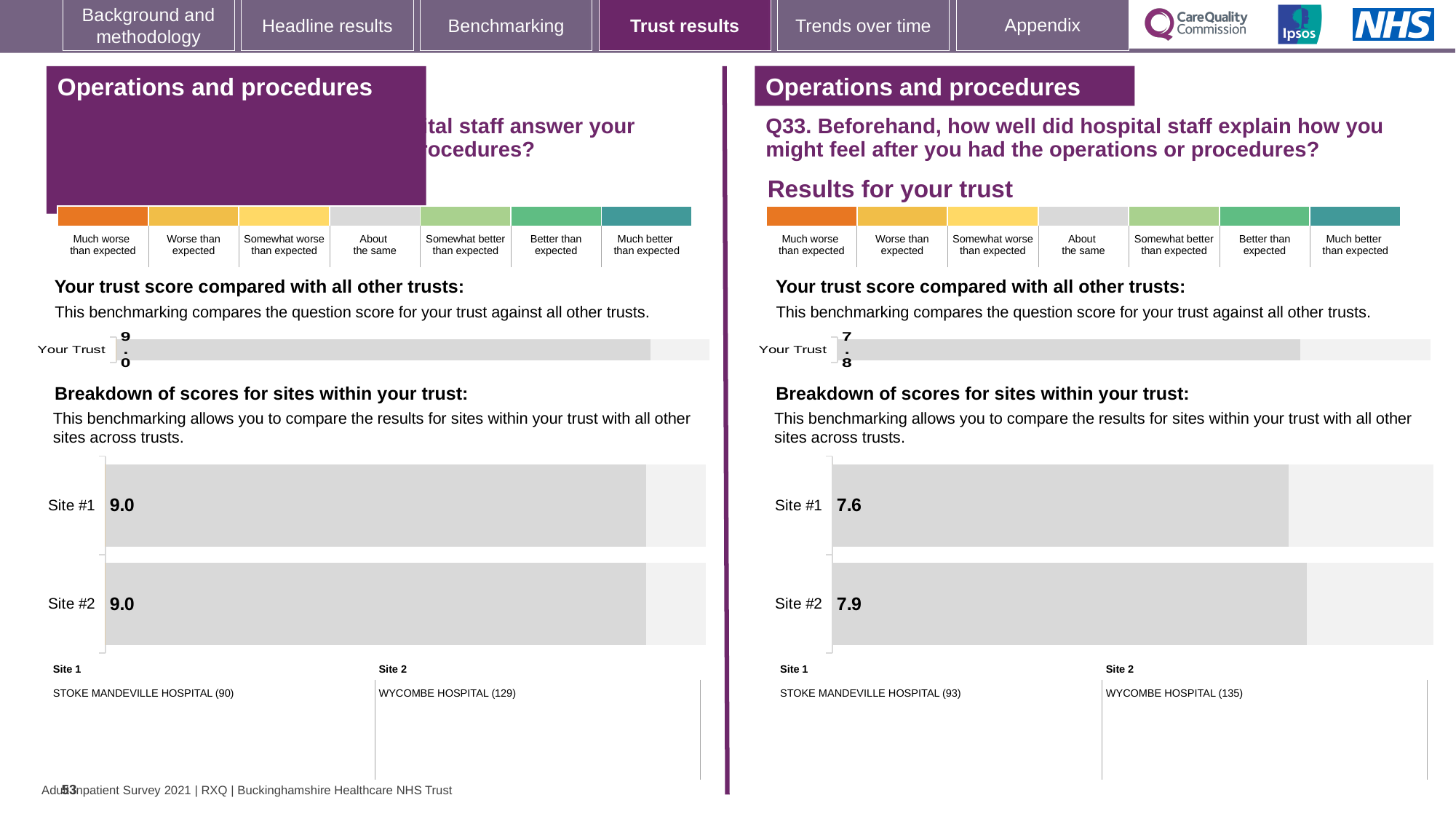
On the right-hand (Q33) 'Breakdown of scores for sites within your trust' chart, what is the score for Site #1? 7.6 On the right-hand (Q33) site breakdown chart, which site has the higher score? Site #2 On the left-hand 'Breakdown of scores for sites within your trust' chart, what is the score for Site #1? 9.0 On the left-hand 'Breakdown of scores for sites within your trust' chart, what is the score for Site #2? 9.0 On the right-hand (Q33) site breakdown chart, what is the difference between the Site #2 and Site #1 scores? 0.3 On the left-hand 'Your trust score compared with all other trusts' chart, what is the score shown for Your Trust? 9.0 On the right-hand (Q33) site breakdown chart, is the score for Site #1 larger or smaller than the score for Site #2? smaller How many sites are shown on the left-hand 'Breakdown of scores for sites within your trust' chart? 2 On the right-hand (Q33) 'Breakdown of scores for sites within your trust' chart, what is the score for Site #2? 7.9 On the right-hand (Q33) site breakdown chart, which hospital is listed as Site 2? WYCOMBE HOSPITAL (135) On the right-hand (Q33) 'Your trust score compared with all other trusts' chart, what is the score shown for Your Trust? 7.8 What type of chart is used for the 'Breakdown of scores for sites within your trust' on the right-hand side? bar chart